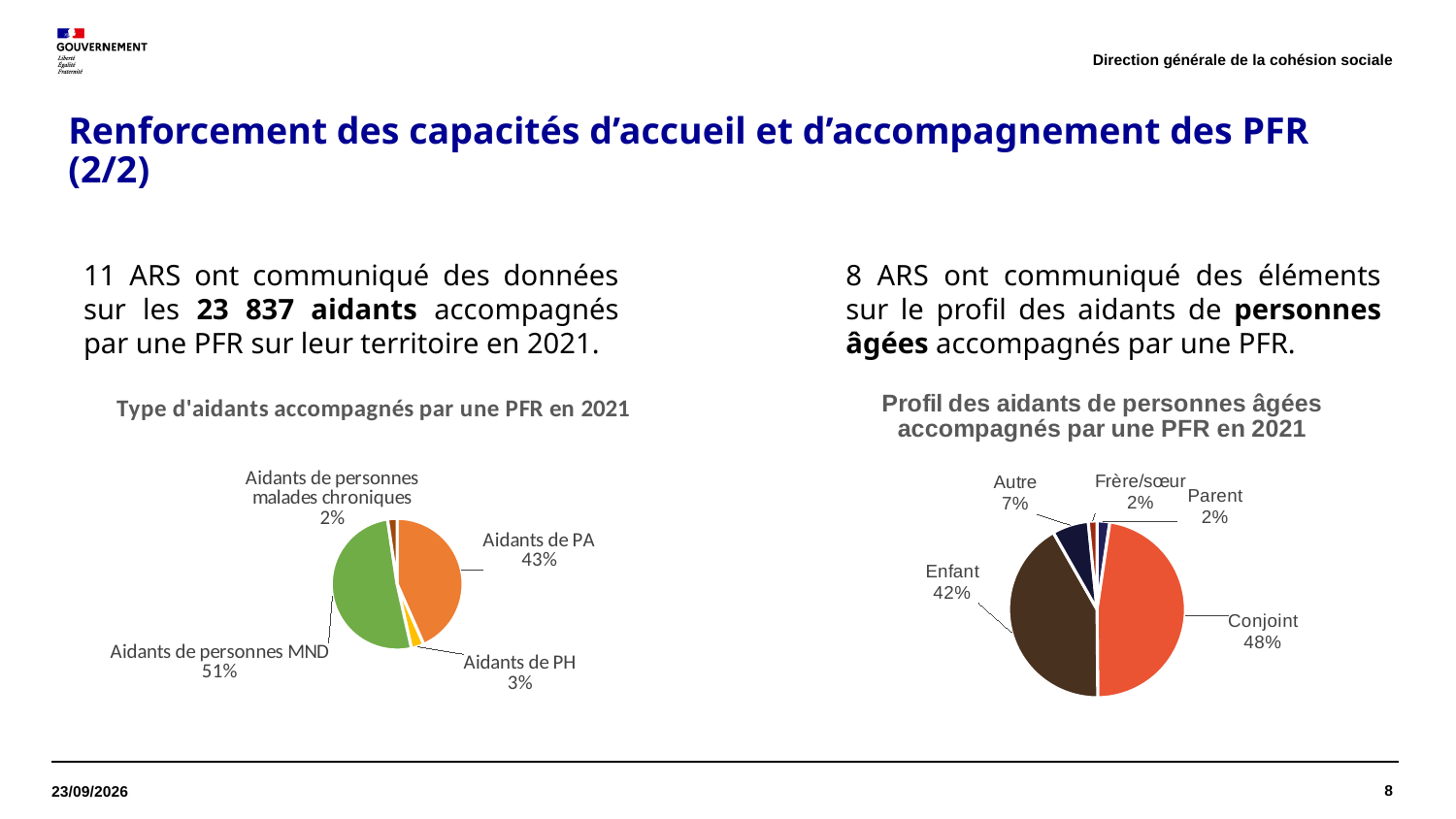
In the chart 'Type d'aidants accompagnés par une PFR en 2021', which category has the largest share? Aidants de personnes MND In the chart 'Profil des aidants de personnes âgées accompagnés par une PFR en 2021', which category has the largest share? Conjoint In the chart 'Type d'aidants accompagnés par une PFR en 2021', how many categories are shown? 4 In the chart 'Profil des aidants de personnes âgées accompagnés par une PFR en 2021', what share is 'Autre'? 7% What type of chart is 'Type d'aidants accompagnés par une PFR en 2021'? Pie chart In the chart 'Type d'aidants accompagnés par une PFR en 2021', what share is 'Aidants de PA'? 43% In the chart 'Profil des aidants de personnes âgées accompagnés par une PFR en 2021', what share is 'Conjoint'? 48% In the chart 'Profil des aidants de personnes âgées accompagnés par une PFR en 2021', how many categories are shown? 5 In the chart 'Type d'aidants accompagnés par une PFR en 2021', which category has the smallest share? Aidants de personnes malades chroniques In the chart 'Profil des aidants de personnes âgées accompagnés par une PFR en 2021', what is the difference between the shares of 'Conjoint' and 'Enfant'? 6 percentage points In the chart 'Profil des aidants de personnes âgées accompagnés par une PFR en 2021', which is larger, 'Enfant' or 'Autre'? Enfant In the chart 'Type d'aidants accompagnés par une PFR en 2021', what is the difference between the shares of 'Aidants de personnes MND' and 'Aidants de PA'? 8 percentage points